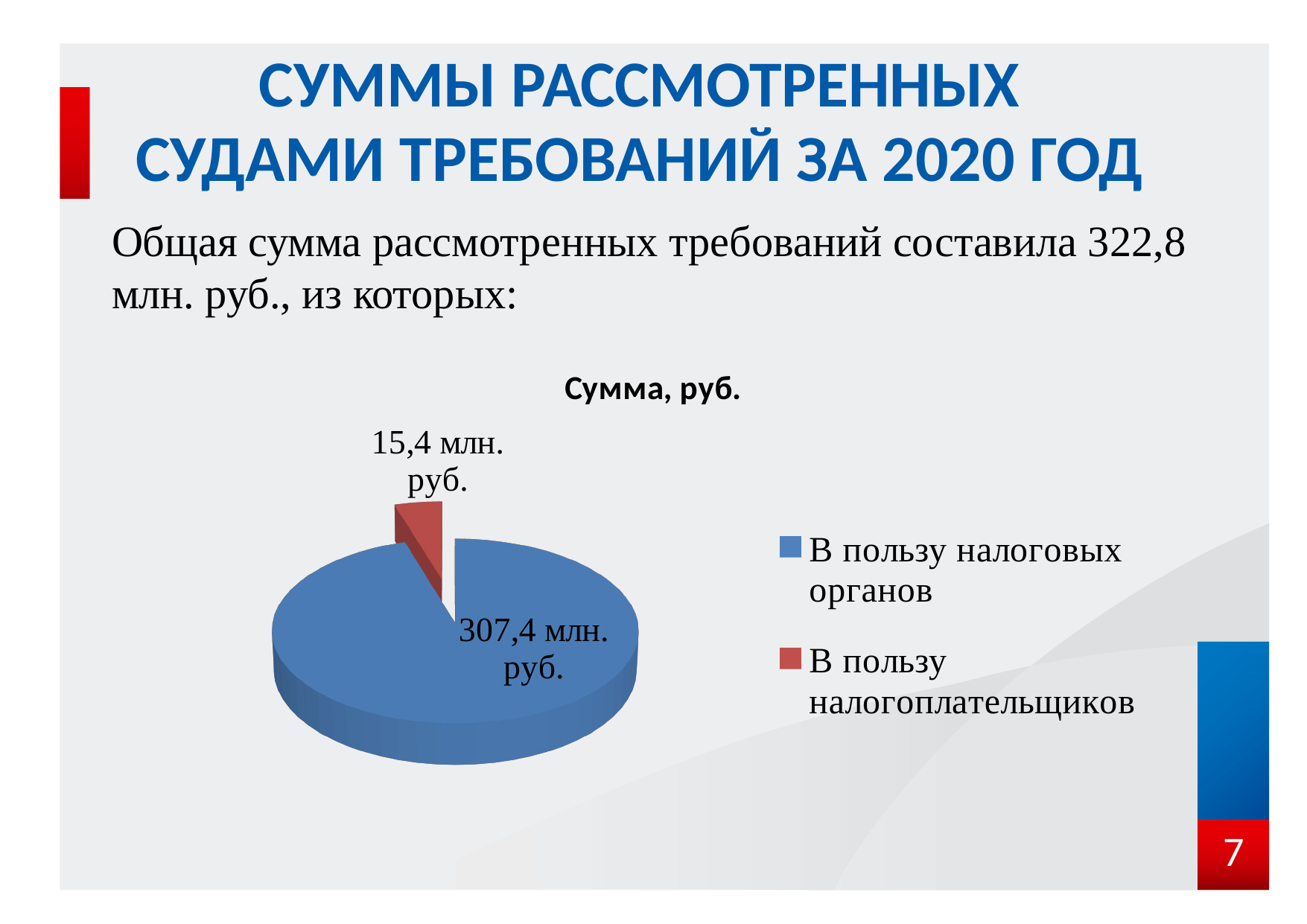
What is the total of the two slices in the pie chart? 322,8 млн. руб. What is the value for "В пользу налогоплательщиков"? 15,4 млн. руб. Which is larger: the amount in favour of tax authorities ("В пользу налоговых органов") or in favour of taxpayers ("В пользу налогоплательщиков")? В пользу налоговых органов How many entries does the legend list? 2 How many slices does the pie chart have? 2 Which category has the smallest slice of the pie? В пользу налогоплательщиков What colour is the slice for "В пользу налогоплательщиков"? red What is the title of the chart? Сумма, руб. What type of chart is shown on the slide? pie chart What is the value for "В пользу налоговых органов"? 307,4 млн. руб. What is the difference between the value for "В пользу налоговых органов" and the value for "В пользу налогоплательщиков"? 292,0 млн. руб. Which category has the largest slice of the pie? В пользу налоговых органов